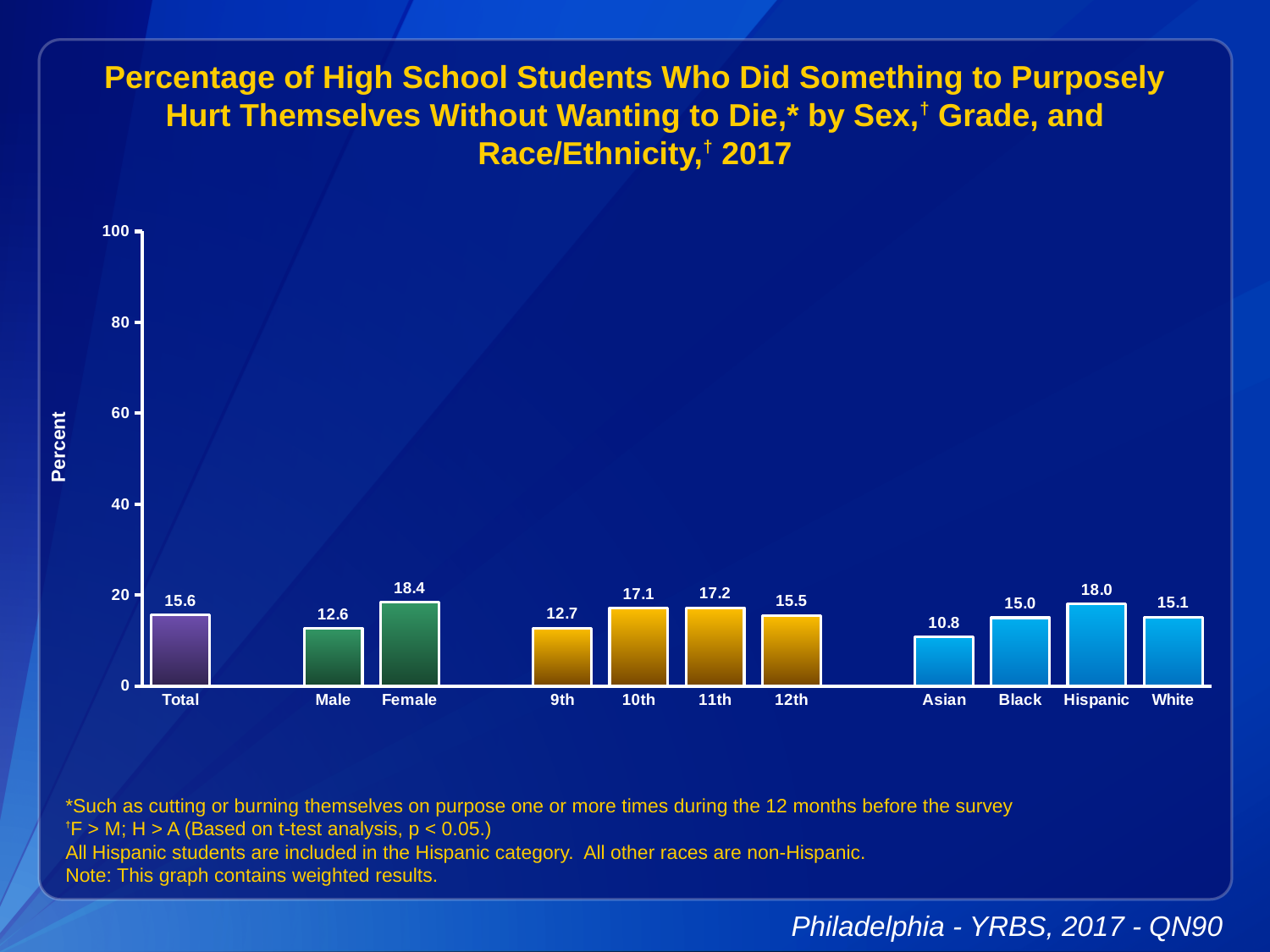
What is the label on the vertical axis? Percent Which category has the highest value? Female Is the value for 10th grade greater or less than 20? less What is the difference between the Female and Male values? 5.8 What is the value for Asian? 10.8 What is the difference between the Hispanic and Asian values? 7.2 What is the value for Female? 18.4 What is the value for Total? 15.6 How many bars are shown in the chart? 11 Which category has the lowest value? Asian What kind of chart is shown on the slide? bar chart Which is larger, the value for Hispanic or the value for White? Hispanic